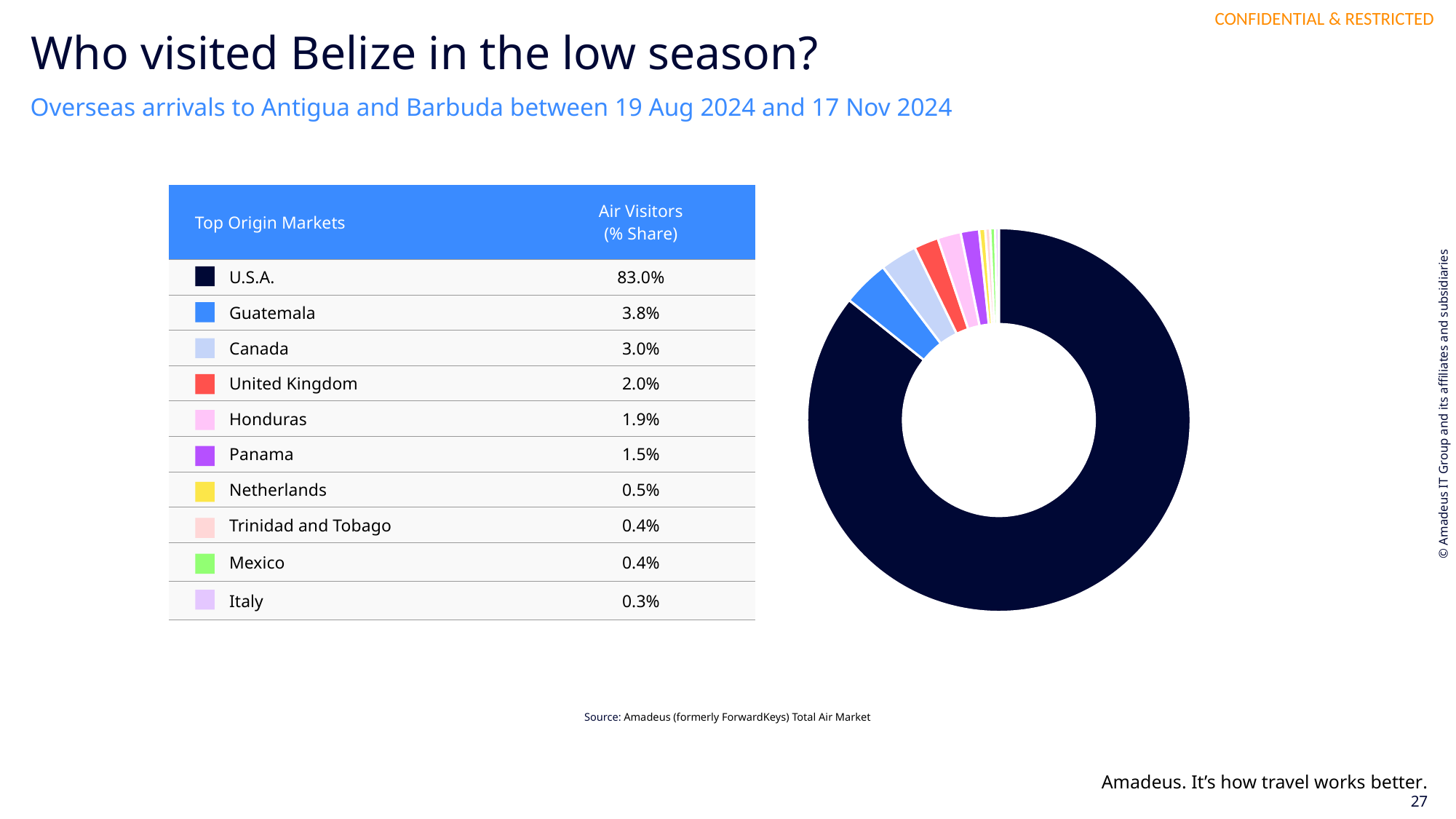
What share of the pie does the U.S.A. slice represent? 83.0% Which origin market has the smallest share of air visitors? Italy What kind of chart is shown on the slide? pie chart (donut) What is the air visitor share for Guatemala? 3.8% Which origin market has the largest share of air visitors? U.S.A. What colour is the U.S.A. slice in the chart? dark navy How many origin markets are listed in the chart's table? 10 Which has a larger share of air visitors, Panama or Netherlands? Panama What is the air visitor share for Netherlands? 0.5% What is the air visitor share for the United Kingdom? 2.0% What is the difference in share between Guatemala and Canada? 0.8 percentage points What is the air visitor share for the U.S.A.? 83.0%